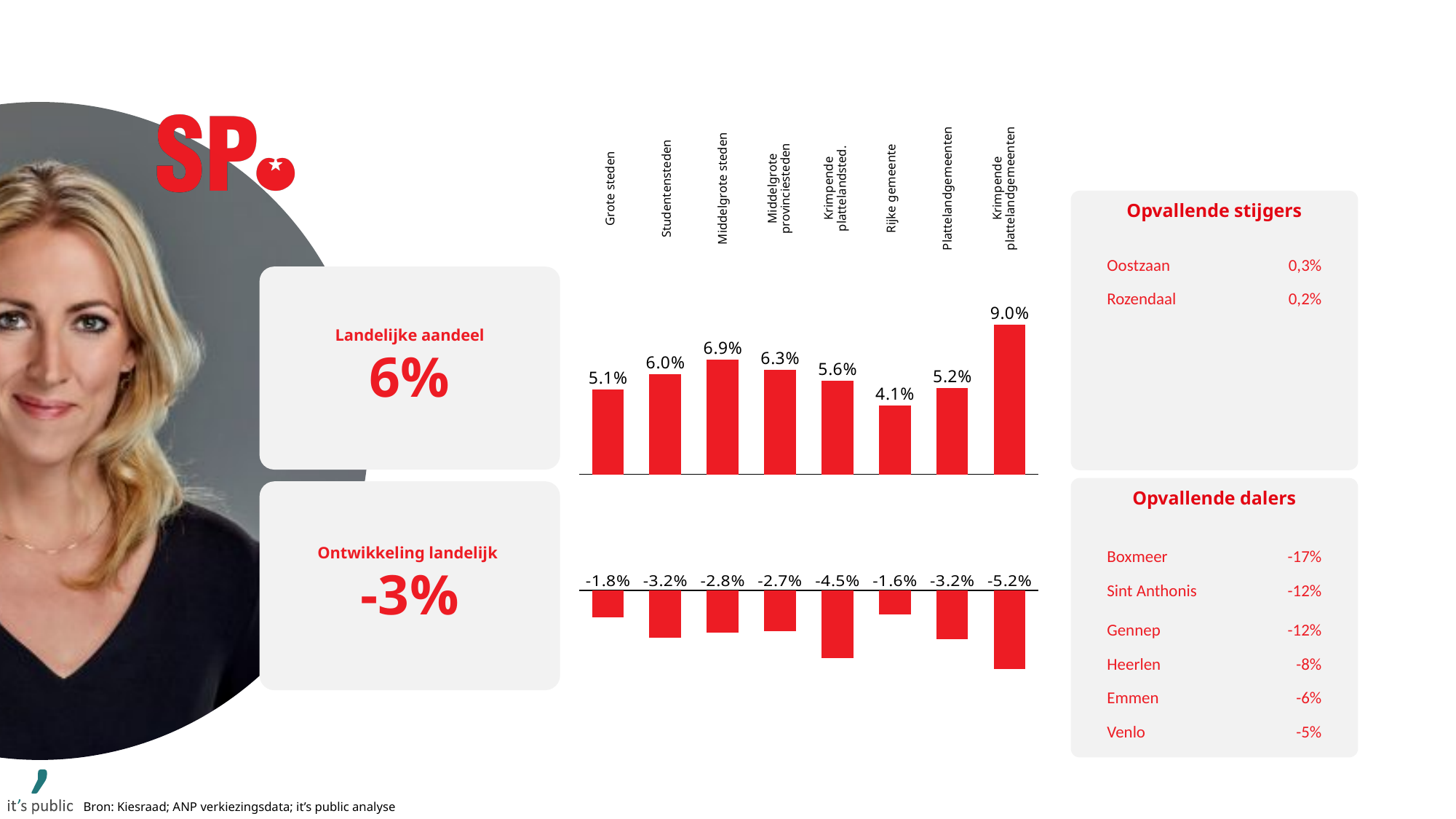
In the lower bar chart, which category has the lowest (most negative) value? Krimpende plattelandgemeenten In the lower bar chart, which category has the highest (least negative) value? Rijke gemeente In the upper bar chart, which category has the highest value? Krimpende plattelandgemeenten In the upper bar chart, which category has the lowest value? Rijke gemeente What kind of chart is the lower chart? bar chart In the upper bar chart, which is larger: Middelgrote provinciesteden or Krimpende plattelandsted.? Middelgrote provinciesteden In the lower bar chart, what is the difference between the values for Grote steden and Studentensteden? 1.4% In the upper bar chart, what is the difference between Middelgrote steden and Studentensteden? 0.9% In the upper bar chart, what is the value for Rijke gemeente? 4.1% In the lower bar chart, what is the value for Krimpende plattelandsted.? -4.5% How many categories are shown in the upper bar chart? 8 In the upper bar chart, what is the value for Grote steden? 5.1%